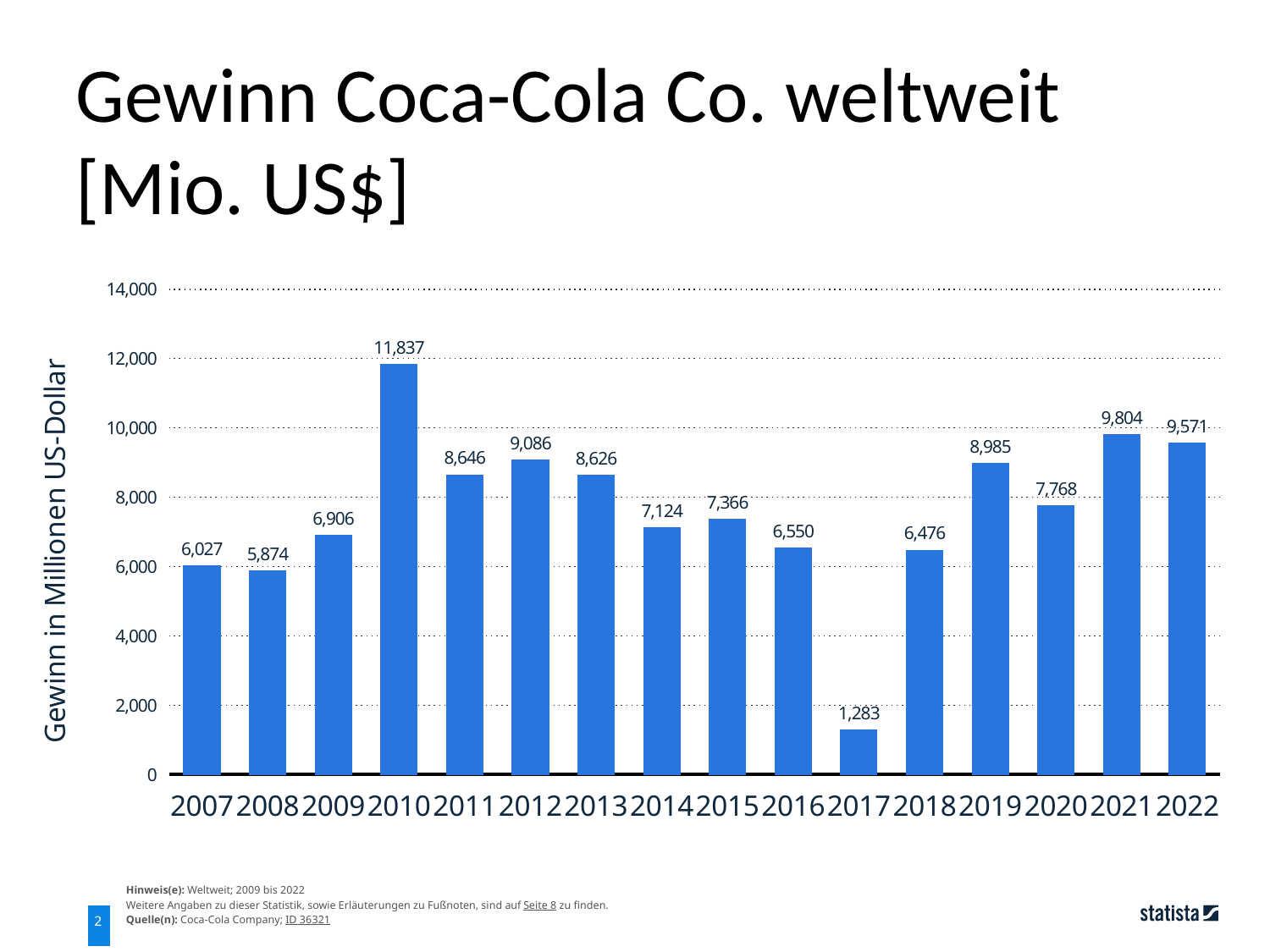
What is the difference between the 2021 value and the 2020 value? 2,036 Did the profit rise or fall from 2021 to 2022? Fall What is the label of the vertical axis? Gewinn in Millionen US-Dollar What value is shown for 2017? 1,283 Which year shows a larger profit, 2012 or 2013? 2012 Which year has the highest profit in the chart? 2010 How many years are shown on the x axis of the chart? 16 Is the value for 2019 greater or less than 8,000? greater What was Coca-Cola's profit in 2010 according to the chart? 11,837 What type of chart is shown on the slide? Bar chart Which year has the lowest profit in the chart? 2017 What is the profit value shown for 2022? 9,571